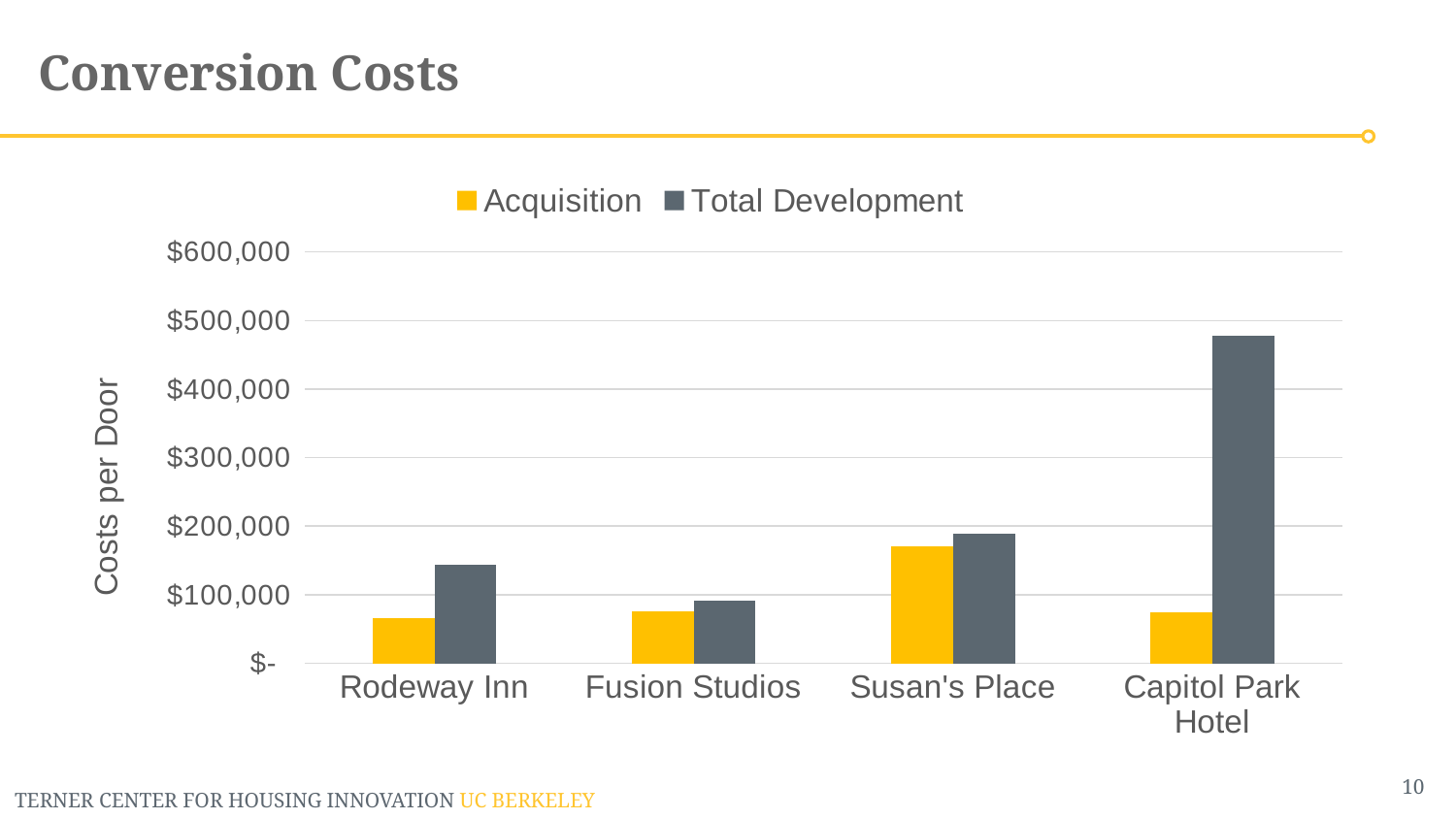
Is the Acquisition value for Susan's Place greater or less than $100,000? greater Which property has the lowest Total Development cost per door? Fusion Studios How many series does the legend list? 2 Is the Total Development value for Capitol Park Hotel greater or less than $400,000? greater Is the Total Development value for Fusion Studios greater or less than $100,000? less Which is larger: the Total Development value for Capitol Park Hotel or for Susan's Place? Capitol Park Hotel What kind of chart is shown on the slide? bar chart Which property has the highest Acquisition cost per door? Susan's Place Which property has the highest Total Development cost per door? Capitol Park Hotel How many properties are shown on the x axis? 4 What is the label on the y axis? Costs per Door